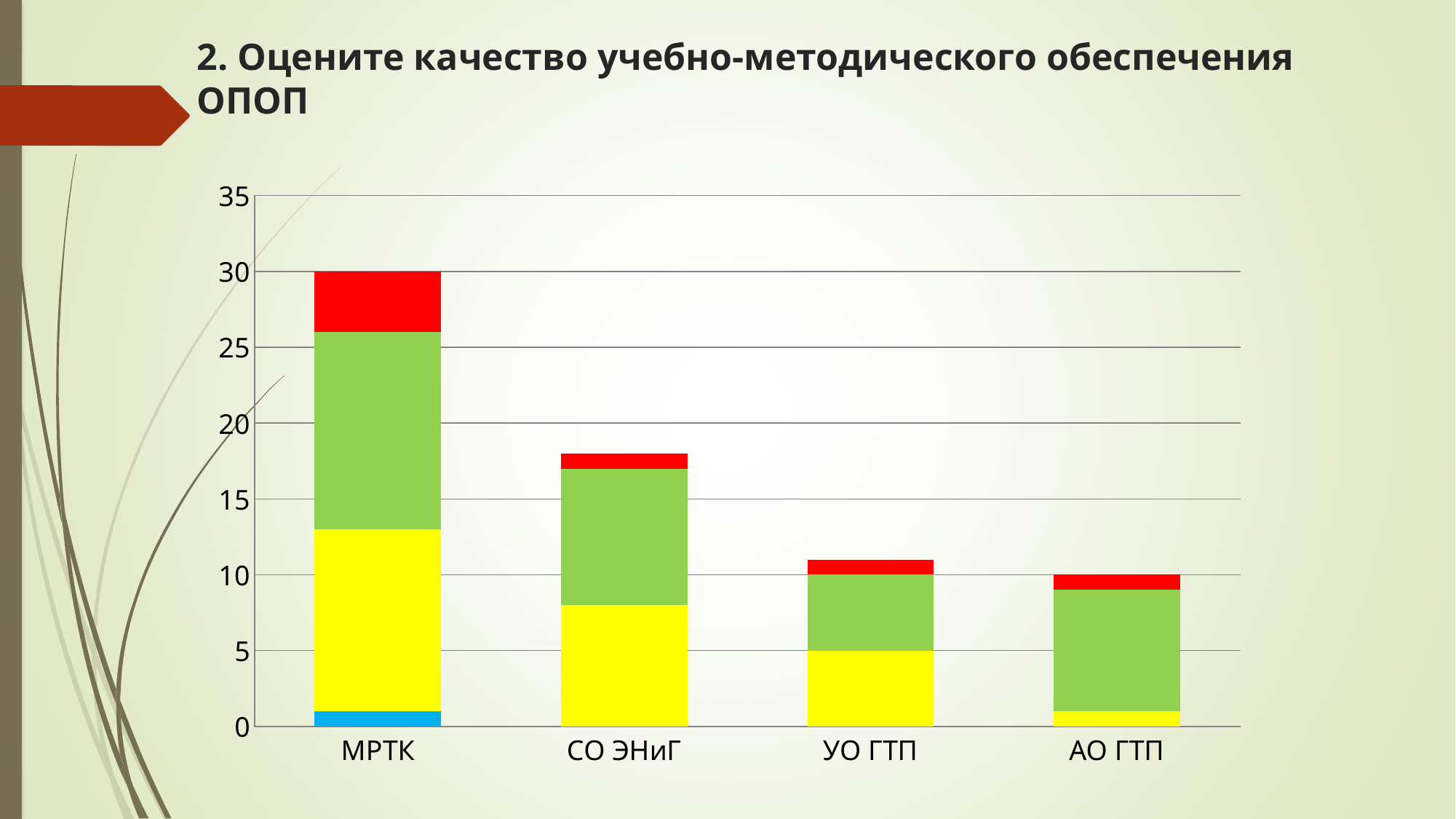
Do the total bar heights rise or fall from left to right across the x axis? Fall Which stacked bar is taller, МРТК or СО ЭНиГ? МРТК Is the total value for СО ЭНиГ greater or less than 15? greater At what axis value does the top of the yellow segment for УО ГТП sit? 5 How many categories are shown on the x axis of the chart? 4 Is the total value for УО ГТП greater or less than 15? less Is the total value for СО ЭНиГ greater or less than 20? less Which category has the tallest stacked bar? МРТК What colour is the bottom segment of the МРТК bar? Blue What type of chart is shown on the slide? Stacked bar chart What is the total height of the stacked bar for АО ГТП? 10 What is the total height of the stacked bar for МРТК? 30